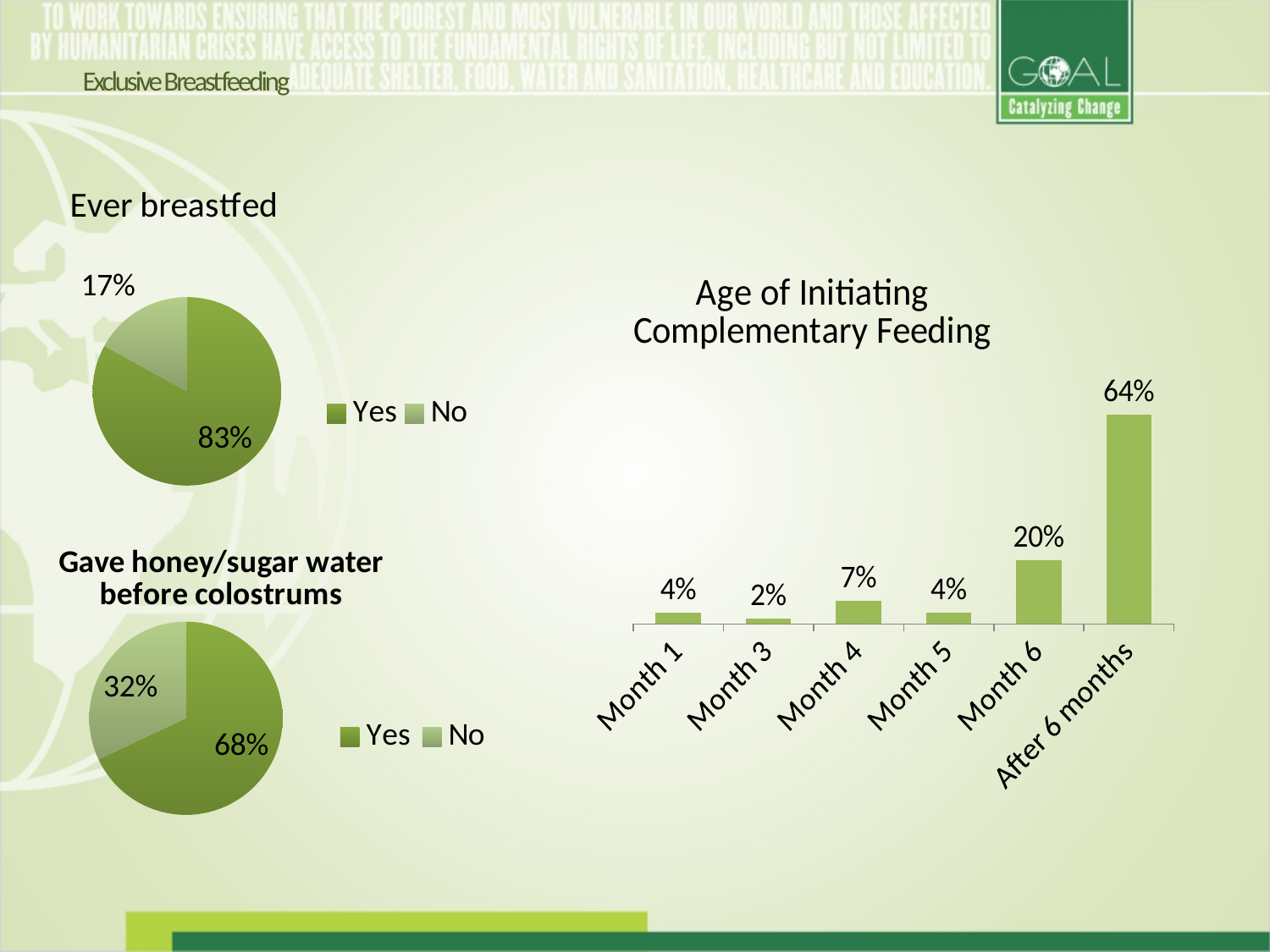
In the 'Age of Initiating Complementary Feeding' chart, which category has the lowest value? Month 3 In the 'Age of Initiating Complementary Feeding' chart, what is the value for Month 6? 20% In the 'Ever breastfed' pie chart, what percentage answered No? 17% In the 'Gave honey/sugar water before colostrums' pie chart, which is larger, Yes or No? Yes In the 'Gave honey/sugar water before colostrums' pie chart, what percentage answered Yes? 68% In the 'Age of Initiating Complementary Feeding' chart, what is the value for Month 4? 7% In the 'Ever breastfed' pie chart, what percentage answered Yes? 83% In the 'Age of Initiating Complementary Feeding' chart, what is the difference between the values for After 6 months and Month 6? 44% In the 'Gave honey/sugar water before colostrums' pie chart, what percentage answered No? 32% What kind of chart is the 'Age of Initiating Complementary Feeding' chart? Bar chart In the 'Age of Initiating Complementary Feeding' chart, which category has the highest value? After 6 months In the 'Age of Initiating Complementary Feeding' chart, how many categories are shown on the x axis? 6